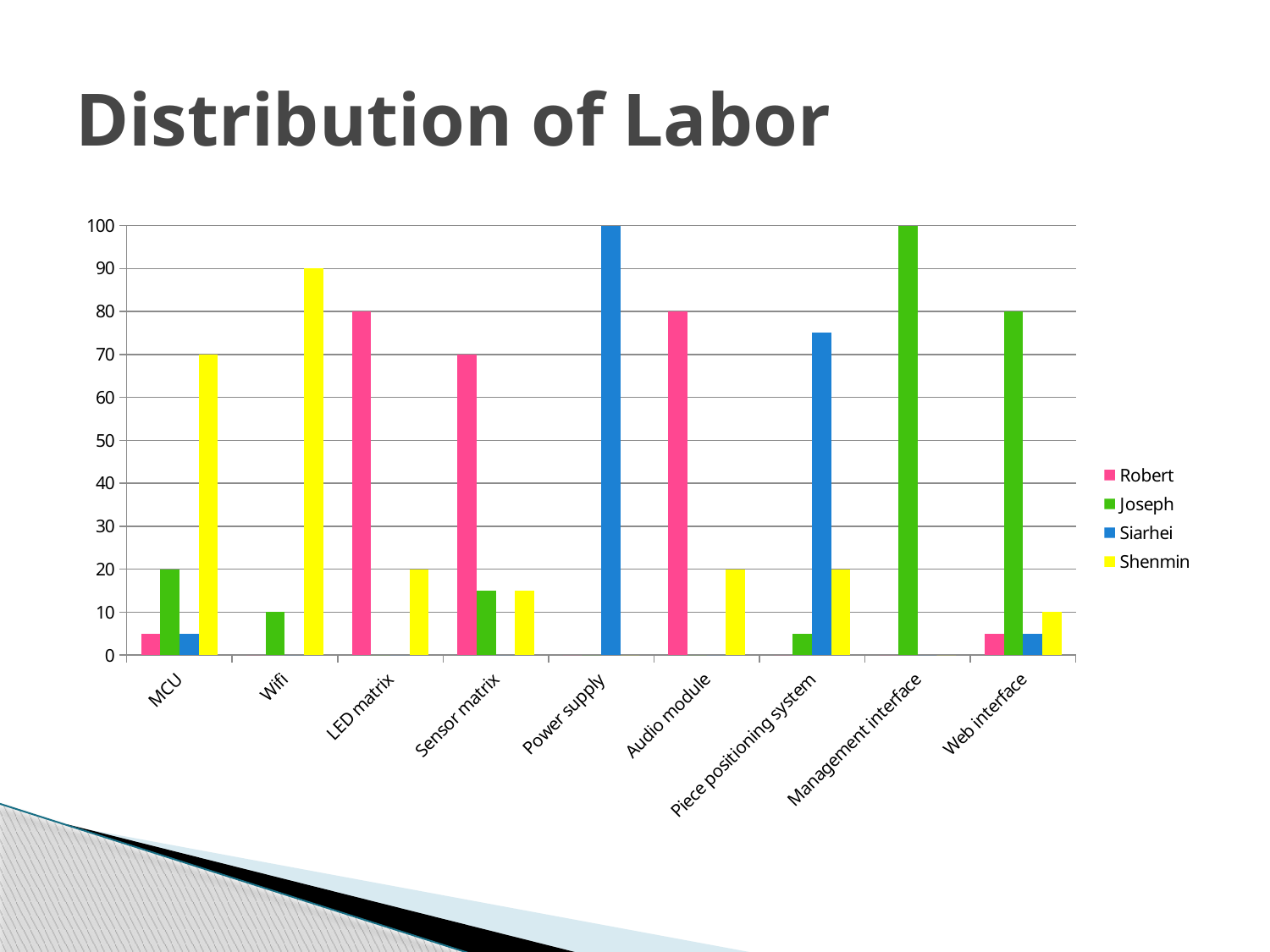
How many categories are shown on the x axis? 9 Which series has the lowest value in the Wifi category among those with a visible bar? Joseph Which series has the highest value in the Management interface category? Joseph What is the value for Shenmin in the Wifi category? 90 What is the value for Robert in the LED matrix category? 80 Is the value for Siarhei in the Piece positioning system category greater or less than 70? greater What is the value for Siarhei in the Power supply category? 100 What is the value for Shenmin in the MCU category? 70 What kind of chart is shown on the slide? bar chart How many series does the legend list? 4 What is the difference between Robert's value and Shenmin's value in the Audio module category? 60 Which is larger: Robert's value for Sensor matrix or Joseph's value for Sensor matrix? Robert